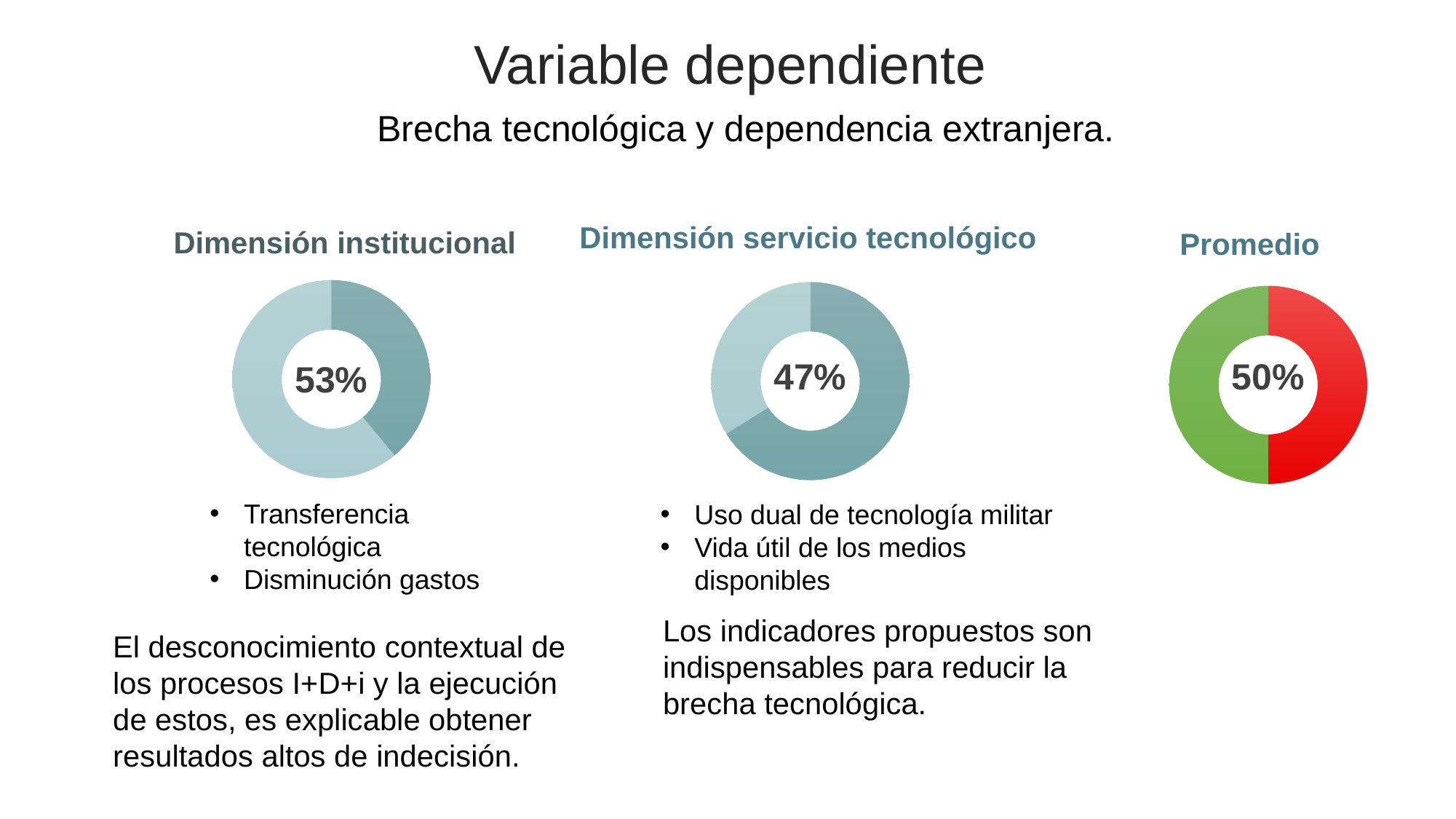
What value is shown in the centre of the 'Promedio' donut chart? 50% What is the difference between the percentage shown for 'Dimensión institucional' and the percentage shown for 'Dimensión servicio tecnológico'? 6% Is the value shown for 'Dimensión servicio tecnológico' greater or less than 50%? less What value is shown in the centre of the 'Dimensión servicio tecnológico' donut chart? 47% Which is larger, the percentage for 'Dimensión institucional' or the percentage for 'Promedio'? Dimensión institucional What value is shown in the centre of the 'Dimensión institucional' donut chart? 53% How many slices does the 'Promedio' donut chart have? 2 Which of the three donut charts shows the lowest percentage? Dimensión servicio tecnológico How many donut charts are on the slide? 3 What kind of chart is used for 'Dimensión institucional'? Donut chart Which of the three donut charts shows the highest percentage? Dimensión institucional What two colours are used in the 'Promedio' donut chart? Green and red